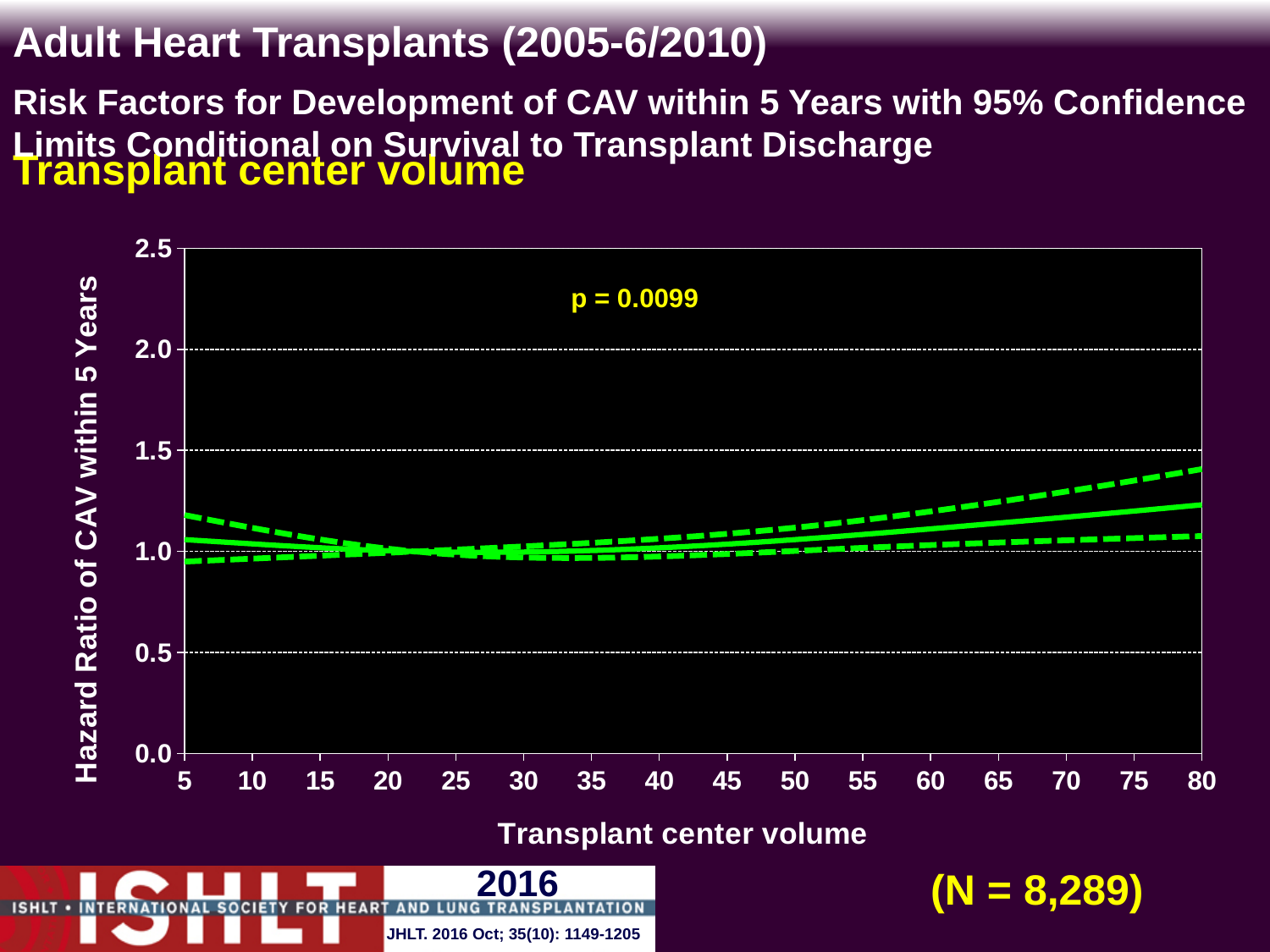
Is the upper confidence limit (upper dashed line) at a transplant center volume of 80 greater or less than 1.5? less What sample size (N) is printed on the slide? N = 8,289 What is the label of the y axis? Hazard Ratio of CAV within 5 Years How many tick labels are shown on the x axis? 16 What is the p-value printed on the chart? p = 0.0099 What is the label of the x axis? Transplant center volume Is the hazard ratio (solid line) at a transplant center volume of 60 greater or less than 1.5? less Between a transplant center volume of 40 and 80, does the hazard ratio (solid line) rise or fall? rise Is the upper confidence limit (upper dashed line) at a transplant center volume of 5 greater or less than 1.0? greater What kind of chart is shown on the slide? line chart What is the highest value labelled on the y axis? 2.5